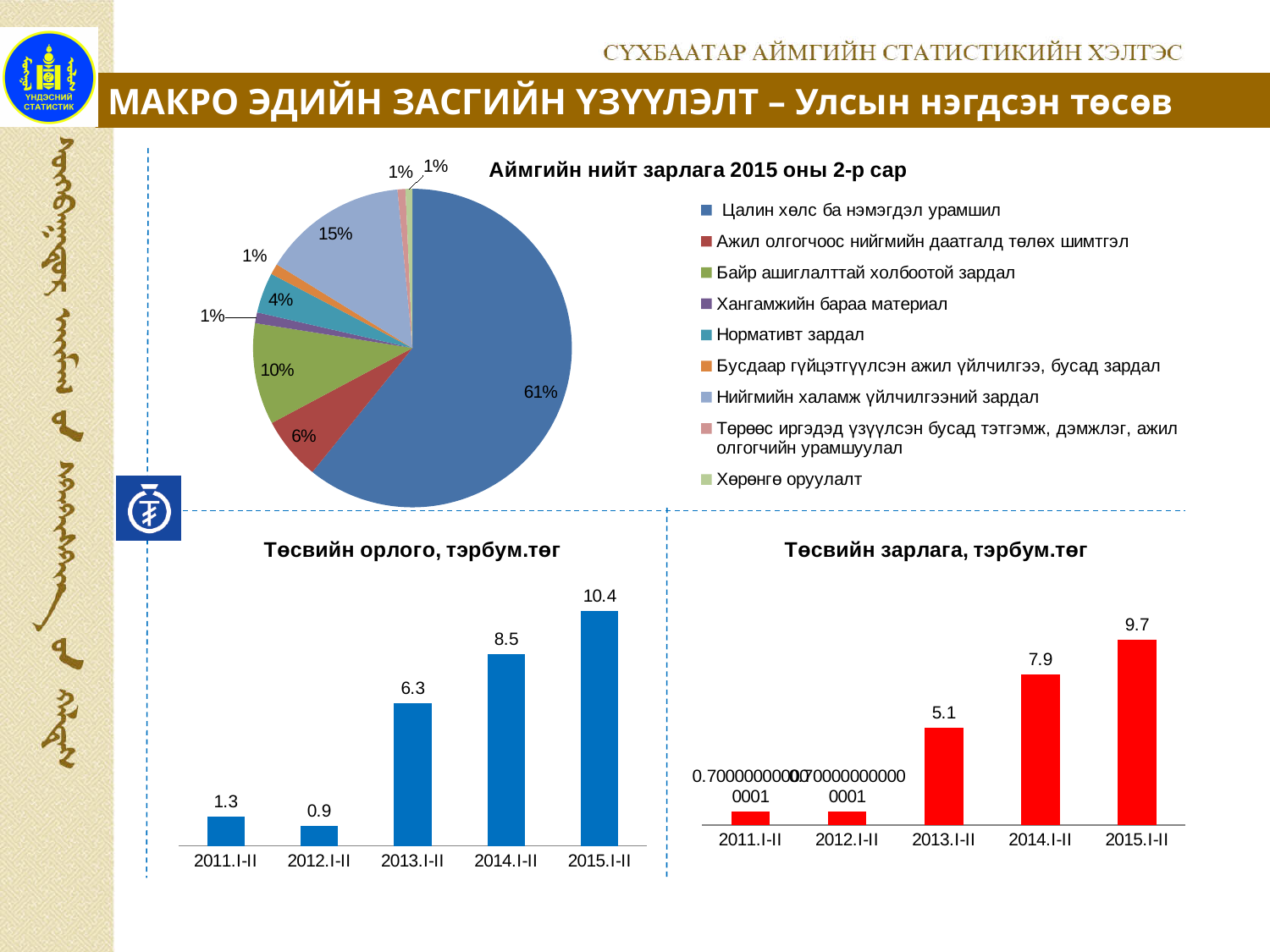
How many entries does the legend of the pie chart 'Аймгийн нийт зарлага 2015 оны 2-р сар' list? 9 In the chart 'Төсвийн зарлага, тэрбум.төг', what is the value for 2014.I-II? 7.9 In the chart 'Төсвийн орлого, тэрбум.төг', which period has the lowest value? 2012.I-II How many periods are shown on the x axis of the chart 'Төсвийн орлого, тэрбум.төг'? 5 In the pie chart 'Аймгийн нийт зарлага 2015 оны 2-р сар', what share does 'Цалин хөлс ба нэмэгдэл урамшил' have? 61% In the pie chart 'Аймгийн нийт зарлага 2015 оны 2-р сар', which is larger: 'Байр ашиглалттай холбоотой зардал' or 'Ажил олгогчоос нийгмийн даатгалд төлөх шимтгэл'? Байр ашиглалттай холбоотой зардал In the pie chart 'Аймгийн нийт зарлага 2015 оны 2-р сар', which category has the largest slice? Цалин хөлс ба нэмэгдэл урамшил In the chart 'Төсвийн орлого, тэрбум.төг', what is the value for 2015.I-II? 10.4 In the chart 'Төсвийн орлого, тэрбум.төг', what is the difference between the values for 2014.I-II and 2013.I-II? 2.2 What type of chart is 'Төсвийн зарлага, тэрбум.төг'? Bar chart In the chart 'Төсвийн зарлага, тэрбум.төг', what is the difference between the values for 2015.I-II and 2013.I-II? 4.6 In the pie chart 'Аймгийн нийт зарлага 2015 оны 2-р сар', what share does 'Нийгмийн халамж үйлчилгээний зардал' have? 15%